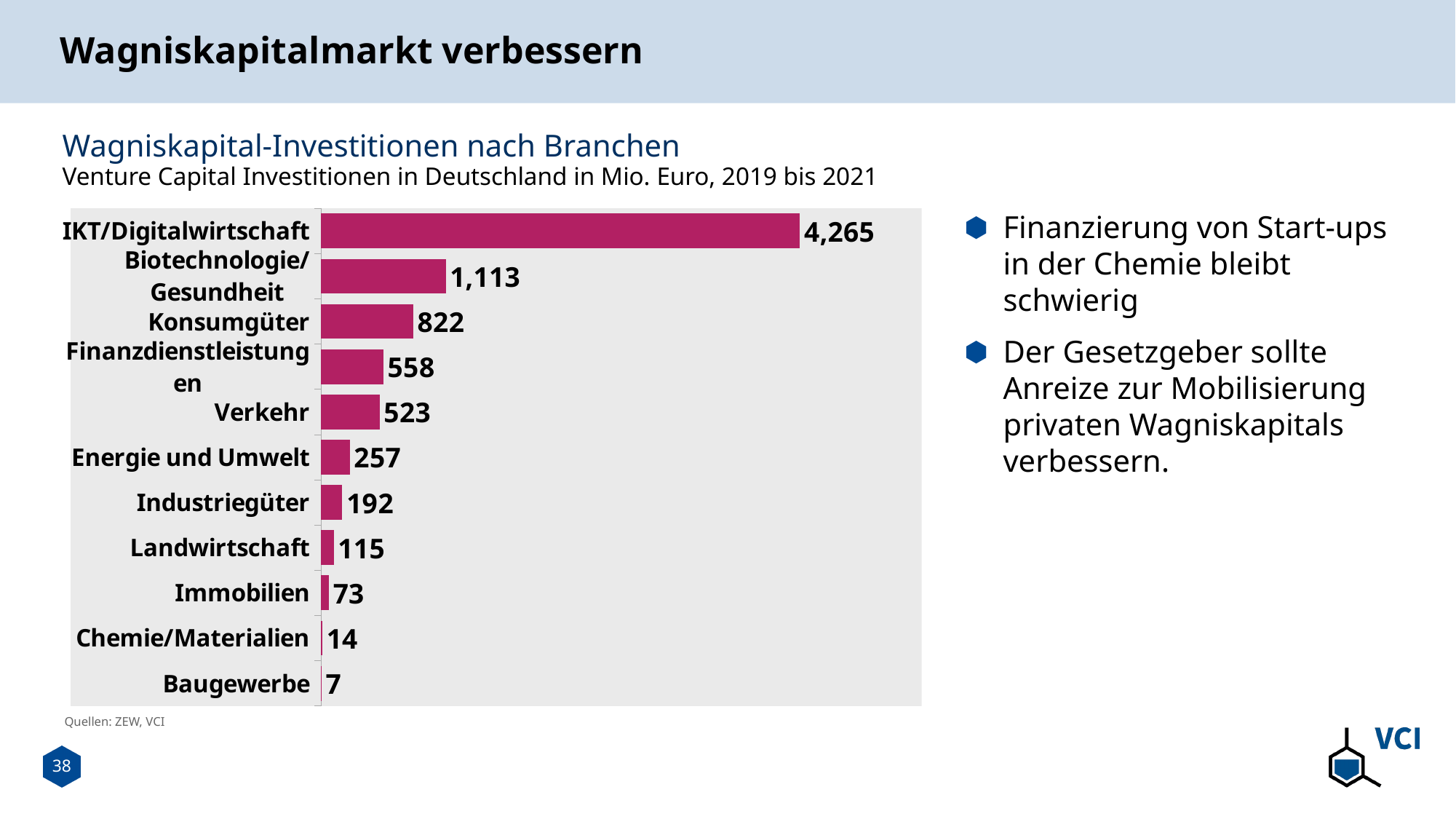
What is the difference between the values for Landwirtschaft and Immobilien? 42 What is the value for Biotechnologie/Gesundheit? 1,113 What is the title of the chart? Wagniskapital-Investitionen nach Branchen Which category has the lowest value? Baugewerbe Which category has the highest value? IKT/Digitalwirtschaft How many categories are shown in the chart? 11 What is the value for Chemie/Materialien? 14 What is the value for IKT/Digitalwirtschaft? 4,265 Which is larger, the value for Energie und Umwelt or the value for Industriegüter? Energie und Umwelt What kind of chart is shown on the slide? Bar chart What is the value for Verkehr? 523 What is the difference between the values for Konsumgüter and Finanzdienstleistungen? 264